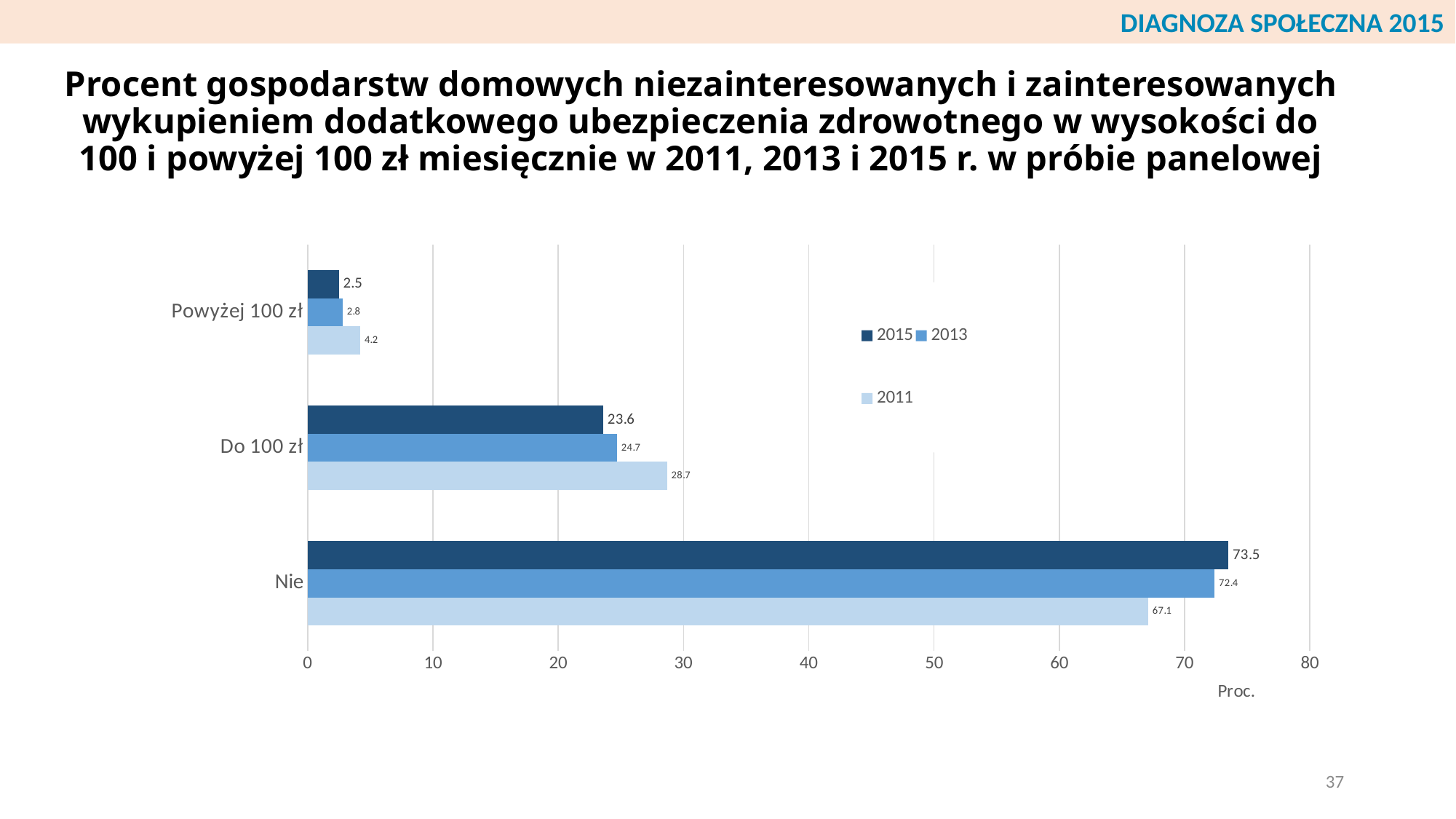
What is the label on the horizontal axis? Proc. What is the difference between the 2015 and 2011 values for 'Nie'? 6.4 Which category has the lowest value in 2011? Powyżej 100 zł What is the value for 'Nie' in 2015? 73.5 What is the value for 'Powyżej 100 zł' in 2013? 2.8 What is the value for 'Do 100 zł' in 2011? 28.7 How many categories are shown on the vertical axis? 3 Is the value for 'Nie' in 2011 greater or less than 60? greater Which category has the highest value in 2015? Nie How many series does the legend list? 3 Which is larger for 'Do 100 zł': the 2013 value or the 2015 value? 2013 What kind of chart is shown on the slide? bar chart